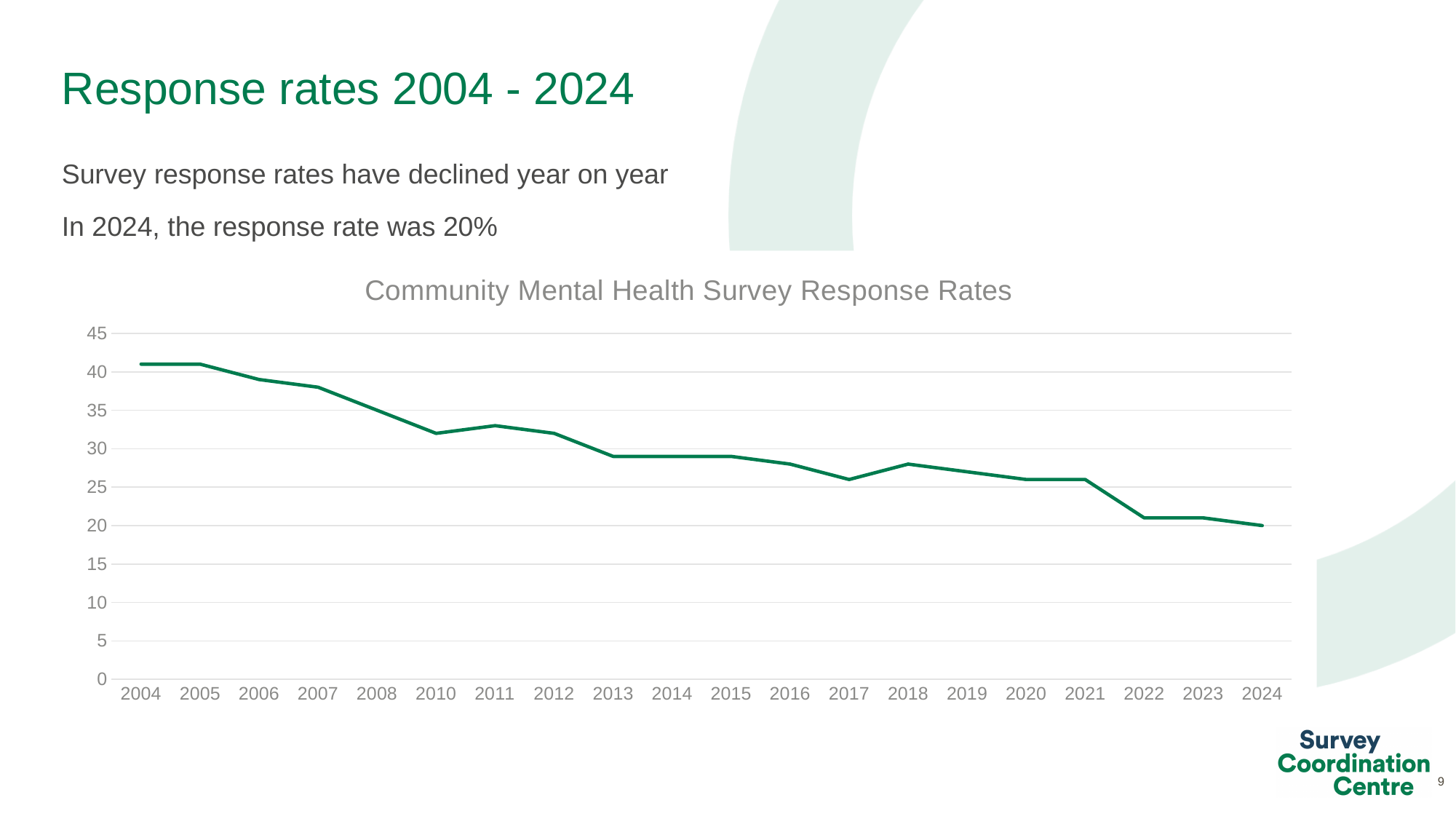
Is the response rate for 2004 greater or less than 35? greater How many years are plotted on the x axis of the chart? 20 What was the response rate in 2024? 20% Which year has the lowest response rate in the chart? 2024 Is the response rate for 2008 greater or less than 30? greater What kind of chart is shown on the slide? Line chart Is the response rate for 2018 greater or less than 25? greater What is the title of the chart? Community Mental Health Survey Response Rates Do the response rates generally rise or fall from 2004 to 2024? Fall Which year has the higher response rate, 2004 or 2024? 2004 Which year has the higher response rate, 2017 or 2018? 2018